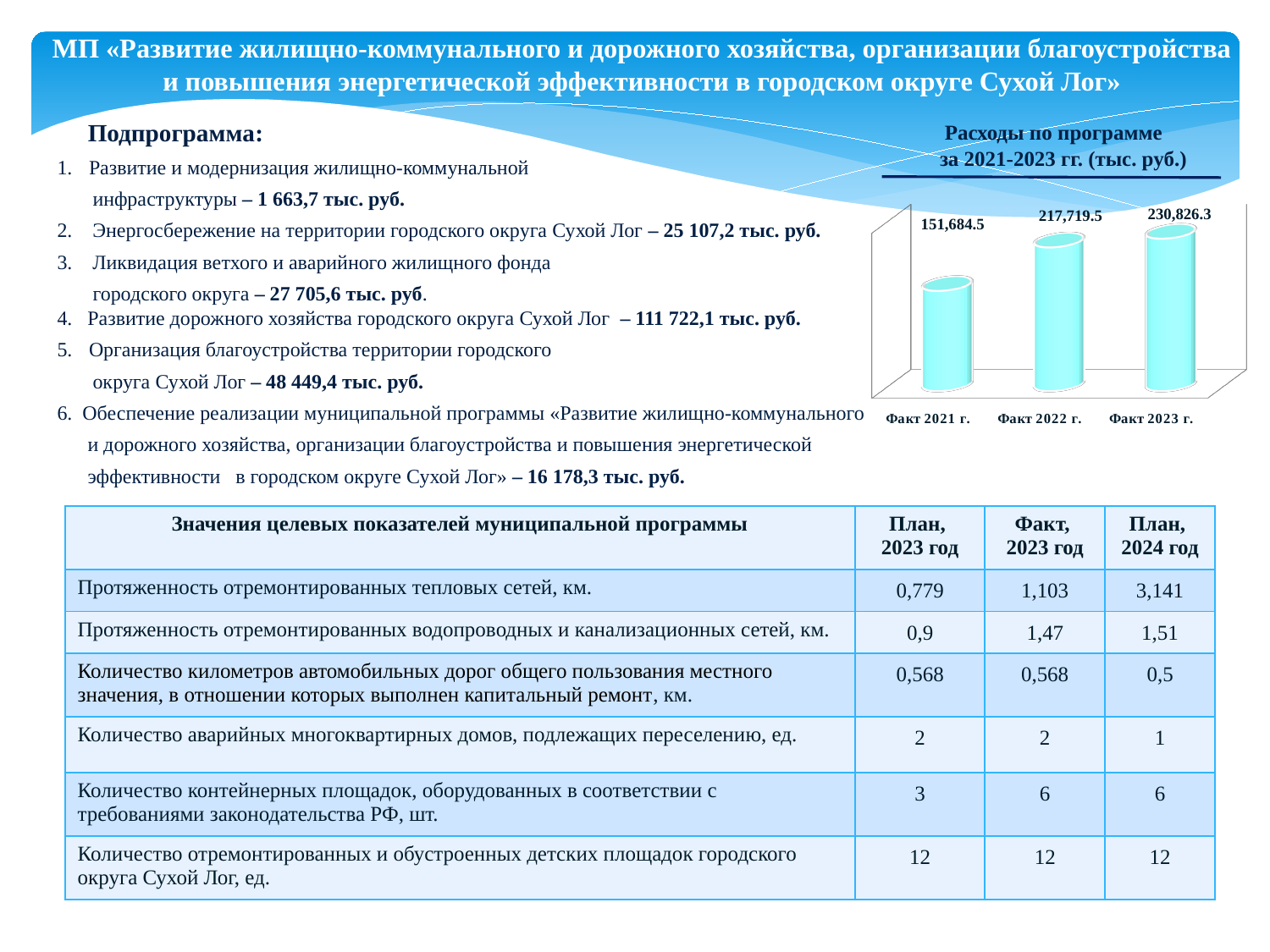
What is the difference between the values for Факт 2023 г. and Факт 2022 г.? 13,106.8 Do the values in the chart rise or fall from Факт 2021 г. to Факт 2023 г.? Rise Which category has the highest value in the chart? Факт 2023 г. What is the value shown for Факт 2021 г. in the chart? 151,684.5 What is the value shown for Факт 2022 г. in the chart? 217,719.5 What is the difference between the values for Факт 2022 г. and Факт 2021 г.? 66,035.0 What is the value shown for Факт 2023 г. in the chart? 230,826.3 Which category has the lowest value in the chart? Факт 2021 г. How many categories are plotted in the chart? 3 What is the title of the chart? Расходы по программе за 2021-2023 гг. (тыс. руб.) What kind of chart is shown on the slide? Bar chart Which is larger, the value for Факт 2021 г. or the value for Факт 2022 г.? Факт 2022 г.